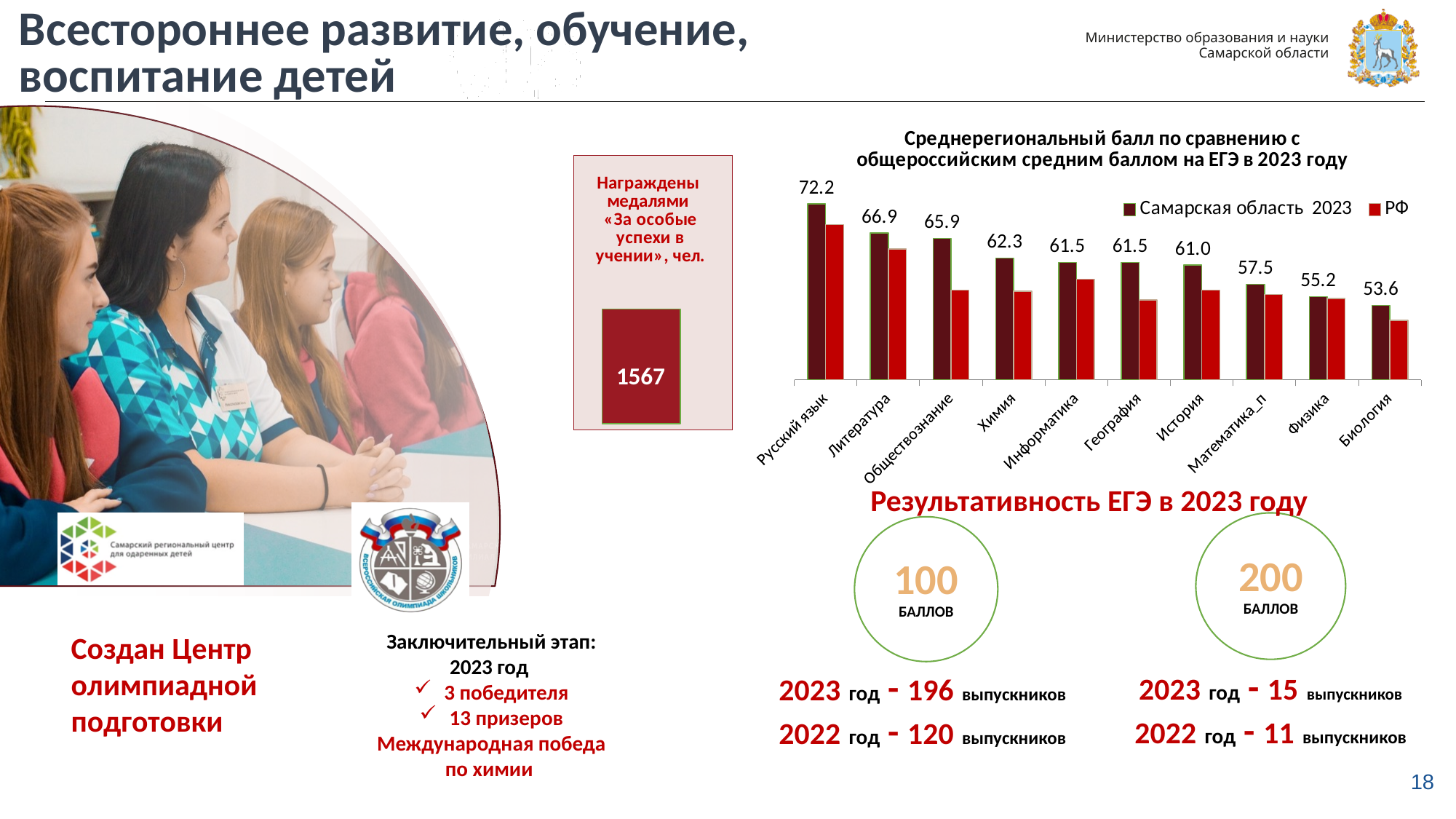
In the chart 'Среднерегиональный балл по сравнению с общероссийским средним баллом на ЕГЭ в 2023 году', what is the value for Самарская область 2023 for Русский язык? 72.2 In the bar chart comparing regional and national ЕГЭ scores, do the Самарская область 2023 values rise or fall from left to right along the x axis? Fall In the bar chart comparing regional and national ЕГЭ scores, what is the difference between the Самарская область 2023 scores for Русский язык and Литература? 5.3 In the bar chart comparing regional and national ЕГЭ scores, what is the Самарская область 2023 value for Математика_п? 57.5 In the bar chart comparing regional and national ЕГЭ scores, for Русский язык, which series has the taller bar: Самарская область 2023 or РФ? Самарская область 2023 How many subjects are shown on the x axis of the bar chart comparing regional and national ЕГЭ scores? 10 How many series does the legend of the bar chart comparing regional and national ЕГЭ scores list? 2 In the bar chart comparing regional and national ЕГЭ scores, which subject has the lowest Самарская область 2023 score? Биология In the bar chart comparing regional and national ЕГЭ scores, which subject has the highest Самарская область 2023 score? Русский язык In the bar chart comparing regional and national ЕГЭ scores, what is the Самарская область 2023 value for Биология? 53.6 What type of chart is used to show the regional versus national ЕГЭ scores in 2023? Bar chart In the bar chart comparing regional and national ЕГЭ scores, which has the higher Самарская область 2023 score: Химия or История? Химия